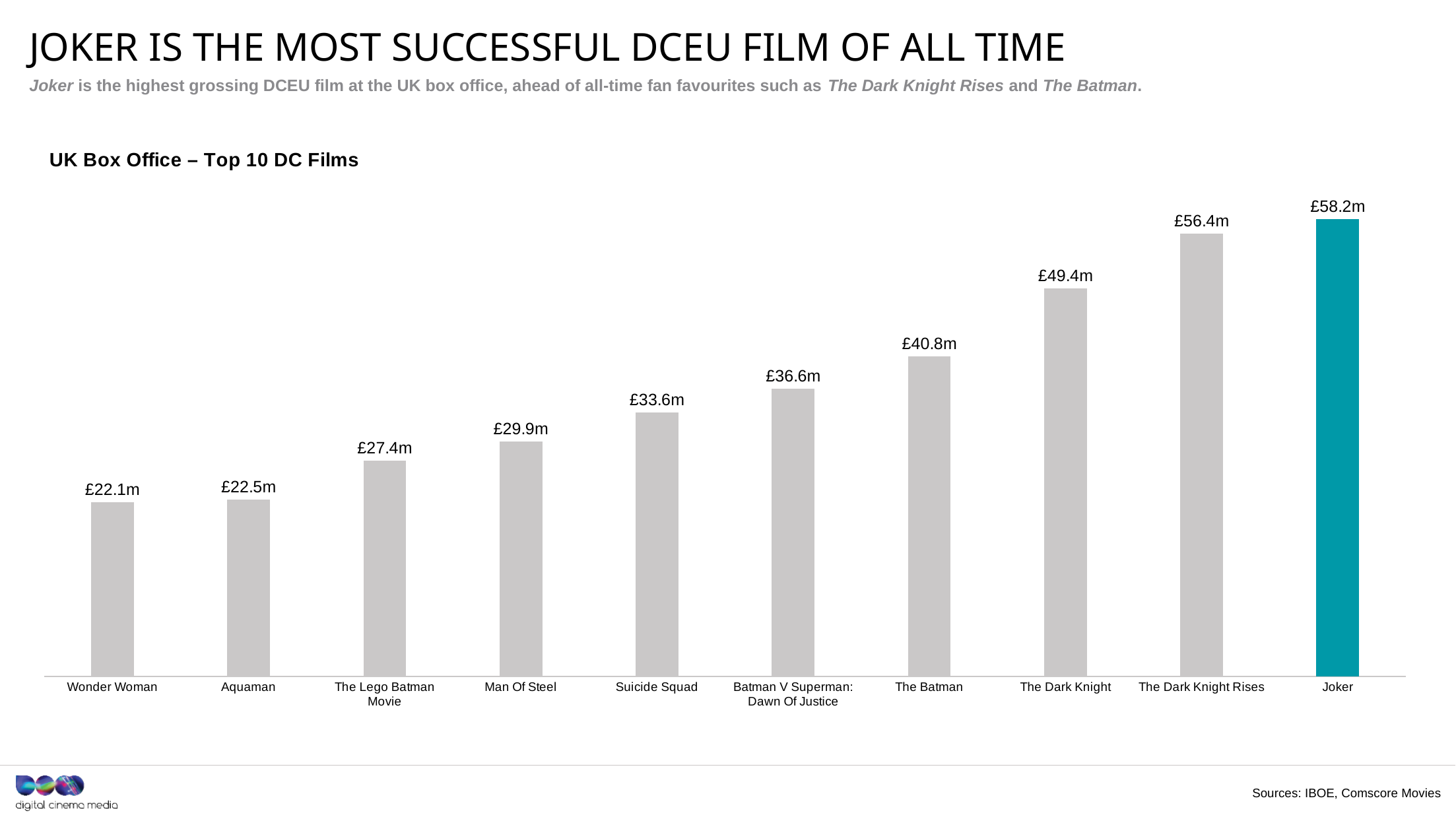
What is the UK box office value for Batman V Superman: Dawn Of Justice? £36.6m Which film has the highest UK box office value on the chart? Joker What is the UK box office value for Suicide Squad? £33.6m What is the UK box office value for The Dark Knight? £49.4m How many films are shown on the chart? 10 Which film has the lowest UK box office value on the chart? Wonder Woman What is the difference between the UK box office values for The Batman and Man Of Steel? £10.9m What is the UK box office value for Joker? £58.2m What is the difference between the UK box office values for Joker and The Dark Knight Rises? £1.8m Which has the larger UK box office value, The Lego Batman Movie or Aquaman? The Lego Batman Movie Do the values rise or fall from left to right along the x axis? Rise What kind of chart is shown on the slide? Bar chart